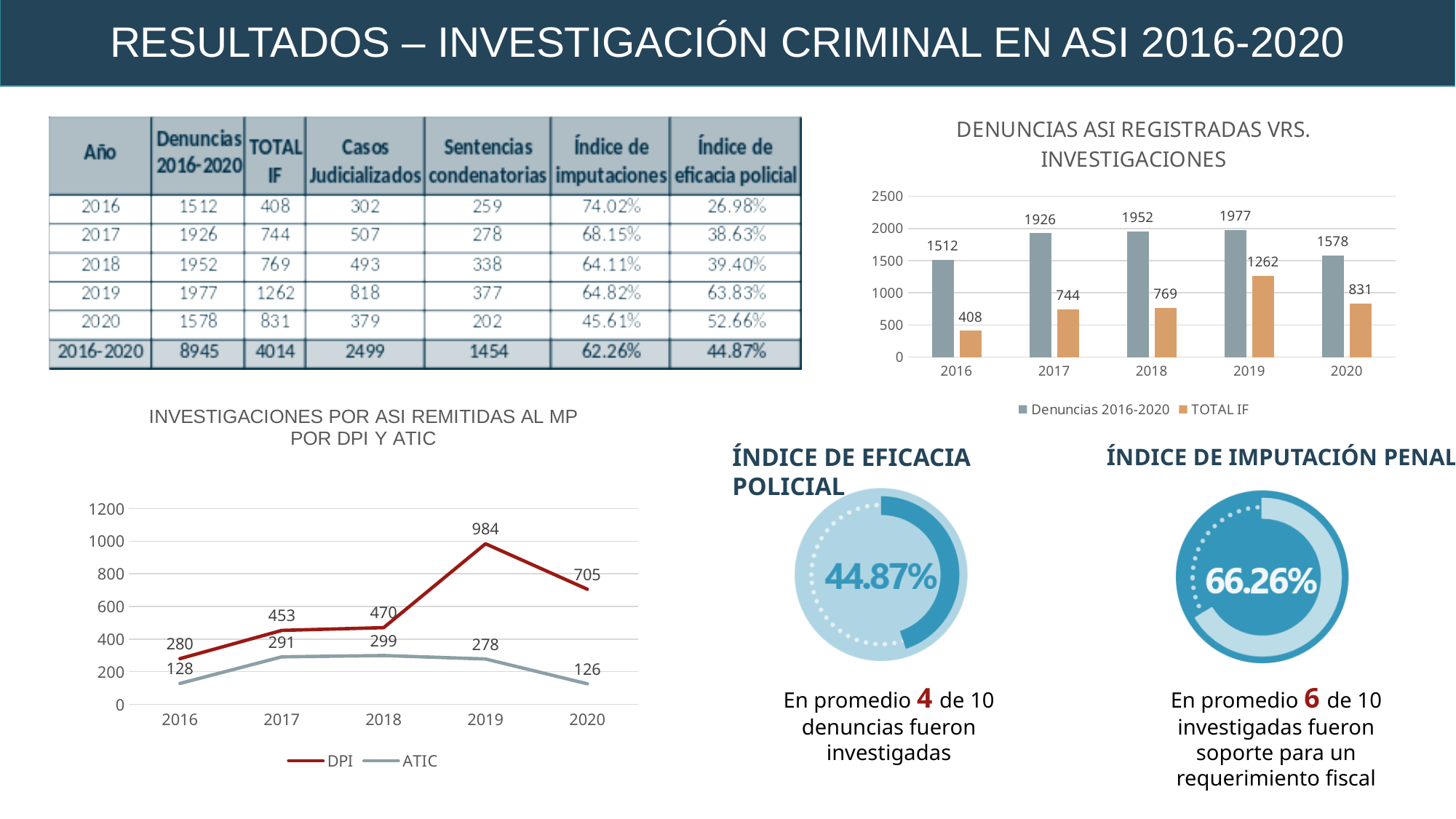
In the chart titled "DENUNCIAS ASI REGISTRADAS VRS. INVESTIGACIONES", what is the value of TOTAL IF for 2017? 744 What kind of chart is the one titled "DENUNCIAS ASI REGISTRADAS VRS. INVESTIGACIONES"? Bar chart In the chart titled "DENUNCIAS ASI REGISTRADAS VRS. INVESTIGACIONES", what is the difference between Denuncias 2016-2020 and TOTAL IF in 2020? 747 In the chart titled "INVESTIGACIONES POR ASI REMITIDAS AL MP POR DPI Y ATIC", how many years are shown on the x axis? 5 In the chart titled "DENUNCIAS ASI REGISTRADAS VRS. INVESTIGACIONES", which year has the lowest Denuncias 2016-2020 value? 2016 What kind of chart is the one titled "INVESTIGACIONES POR ASI REMITIDAS AL MP POR DPI Y ATIC"? Line chart In the chart titled "INVESTIGACIONES POR ASI REMITIDAS AL MP POR DPI Y ATIC", what is the ATIC value for 2020? 126 In the chart titled "DENUNCIAS ASI REGISTRADAS VRS. INVESTIGACIONES", which year has the highest TOTAL IF value? 2019 In the chart titled "DENUNCIAS ASI REGISTRADAS VRS. INVESTIGACIONES", what is the value of Denuncias 2016-2020 for 2019? 1977 In the chart titled "INVESTIGACIONES POR ASI REMITIDAS AL MP POR DPI Y ATIC", what is the DPI value for 2019? 984 In the chart titled "INVESTIGACIONES POR ASI REMITIDAS AL MP POR DPI Y ATIC", which is larger in 2018, DPI or ATIC? DPI In the chart titled "DENUNCIAS ASI REGISTRADAS VRS. INVESTIGACIONES", how many series does the legend list? 2